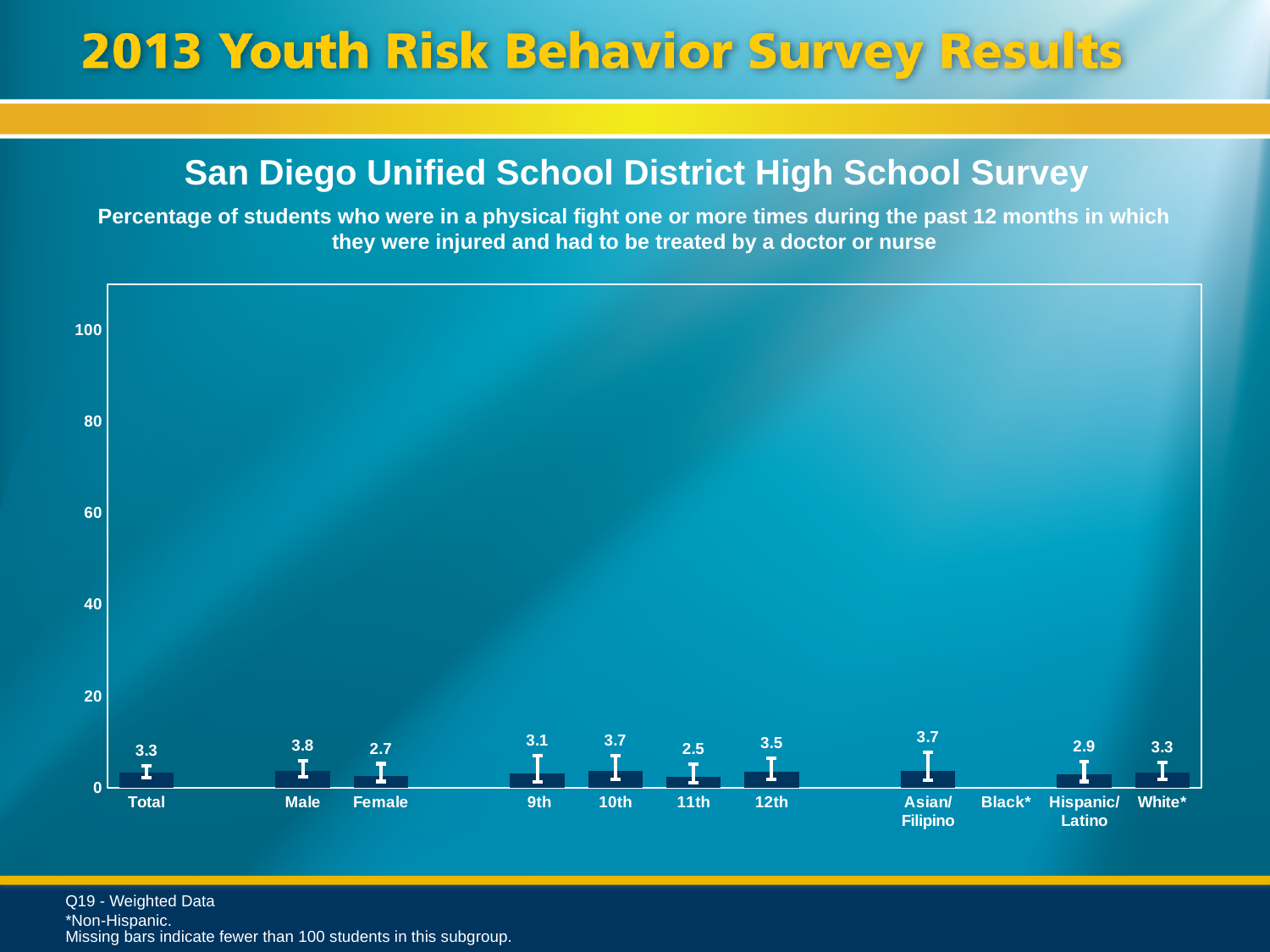
What is the value for Male? 3.8 Which is larger, the value for 10th grade or the value for 9th grade? 10th What is the value for 11th grade? 2.5 Which category has the highest value? Male What is the value for Asian/Filipino? 3.7 How many categories are labeled on the x axis? 11 What is the value for Hispanic/Latino? 2.9 Which category on the x axis has no bar plotted? Black* What is the difference between the values for Male and Female? 1.1 Is the value for Total greater or less than 20? less Which category has the lowest value? 11th What kind of chart is shown on the slide? bar chart